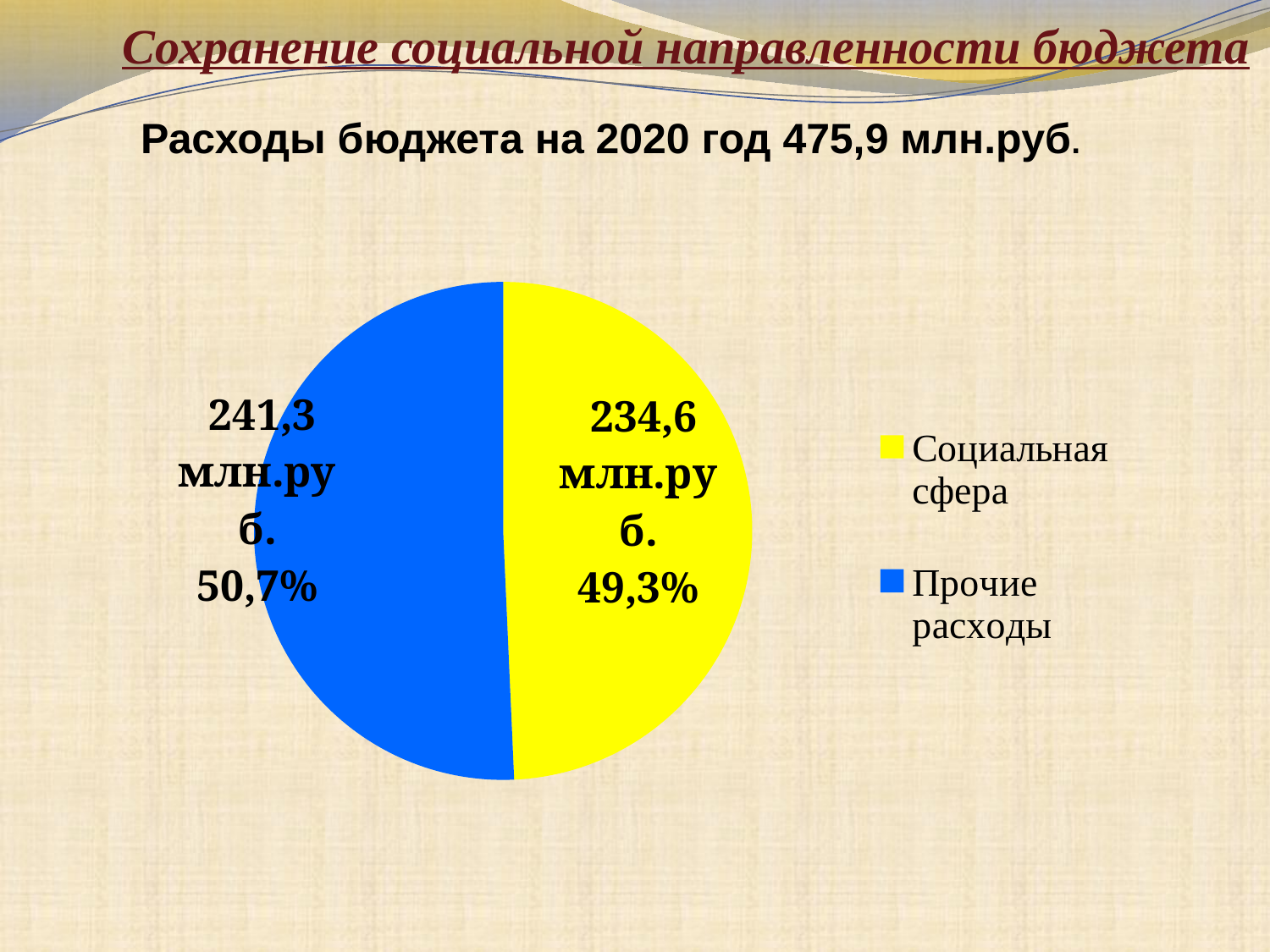
Which slice is the smallest? Социальная сфера How many entries does the legend list? 2 How many slices does the pie chart have? 2 What is the value for Социальная сфера in млн.руб.? 234,6 млн.руб. Which is larger, Социальная сфера or Прочие расходы? Прочие расходы Which slice is the largest? Прочие расходы Which colour represents Социальная сфера in the pie chart? yellow What is the value for Прочие расходы in млн.руб.? 241,3 млн.руб. What is the difference in млн.руб. between Прочие расходы and Социальная сфера? 6,7 млн.руб. What kind of chart is shown on the slide? pie chart What share of the pie does Социальная сфера take? 49,3% What share of the pie does Прочие расходы take? 50,7%